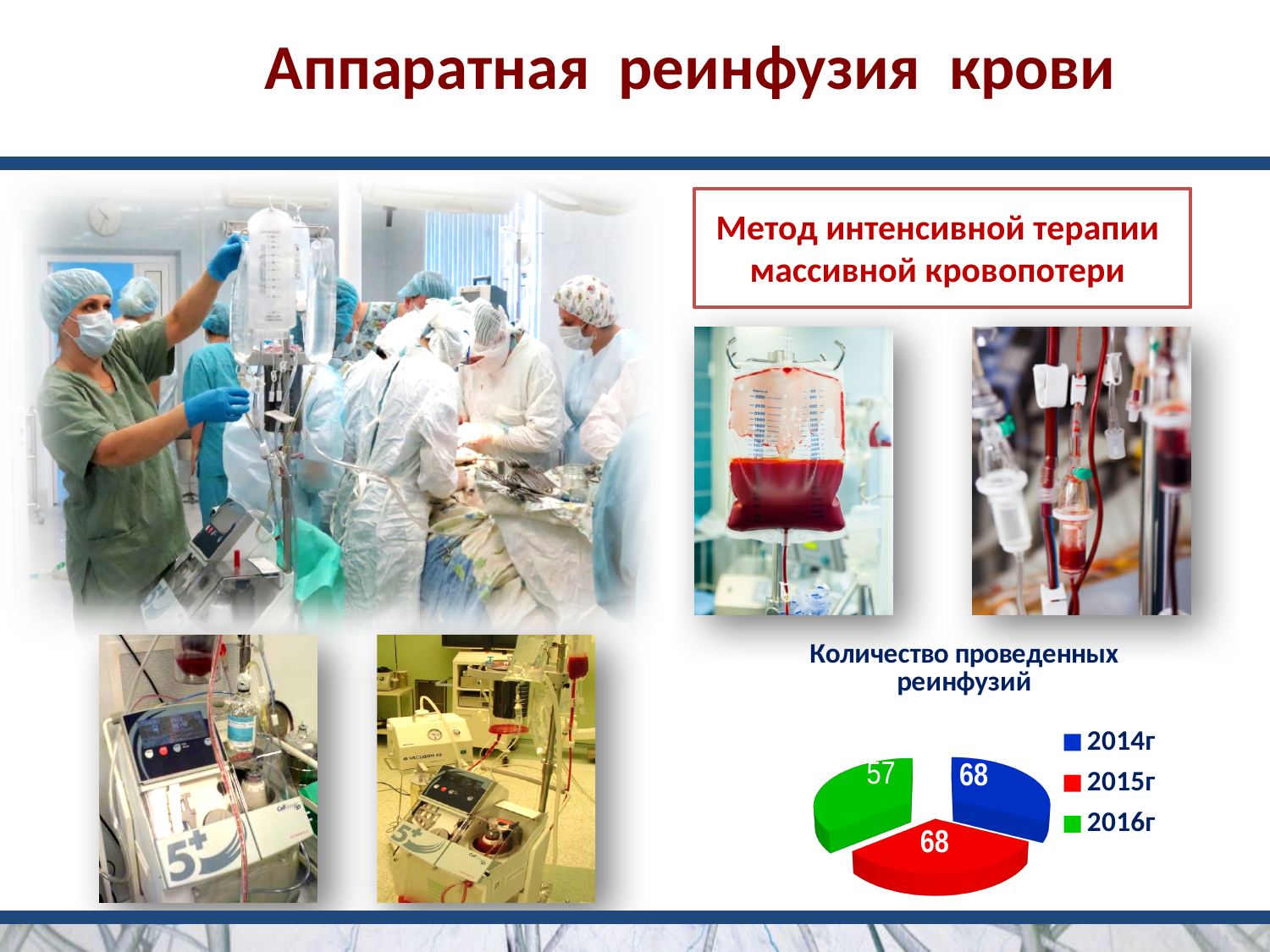
What kind of chart is shown on the slide? pie chart How many slices does the pie chart have? 3 Which colour represents 2016г in the pie chart? green Which is larger in the pie chart, the value for 2014г or the value for 2016г? 2014г What is the value for 2016г in the pie chart? 57 What is the difference between the values for 2015г and 2016г in the pie chart? 11 What is the title of the chart on the slide? Количество проведенных реинфузий How many entries does the legend of the pie chart list? 3 Which year has the lowest value in the pie chart? 2016г What is the total of all slices in the pie chart? 193 What is the value for 2014г in the pie chart? 68 What is the value for 2015г in the pie chart? 68